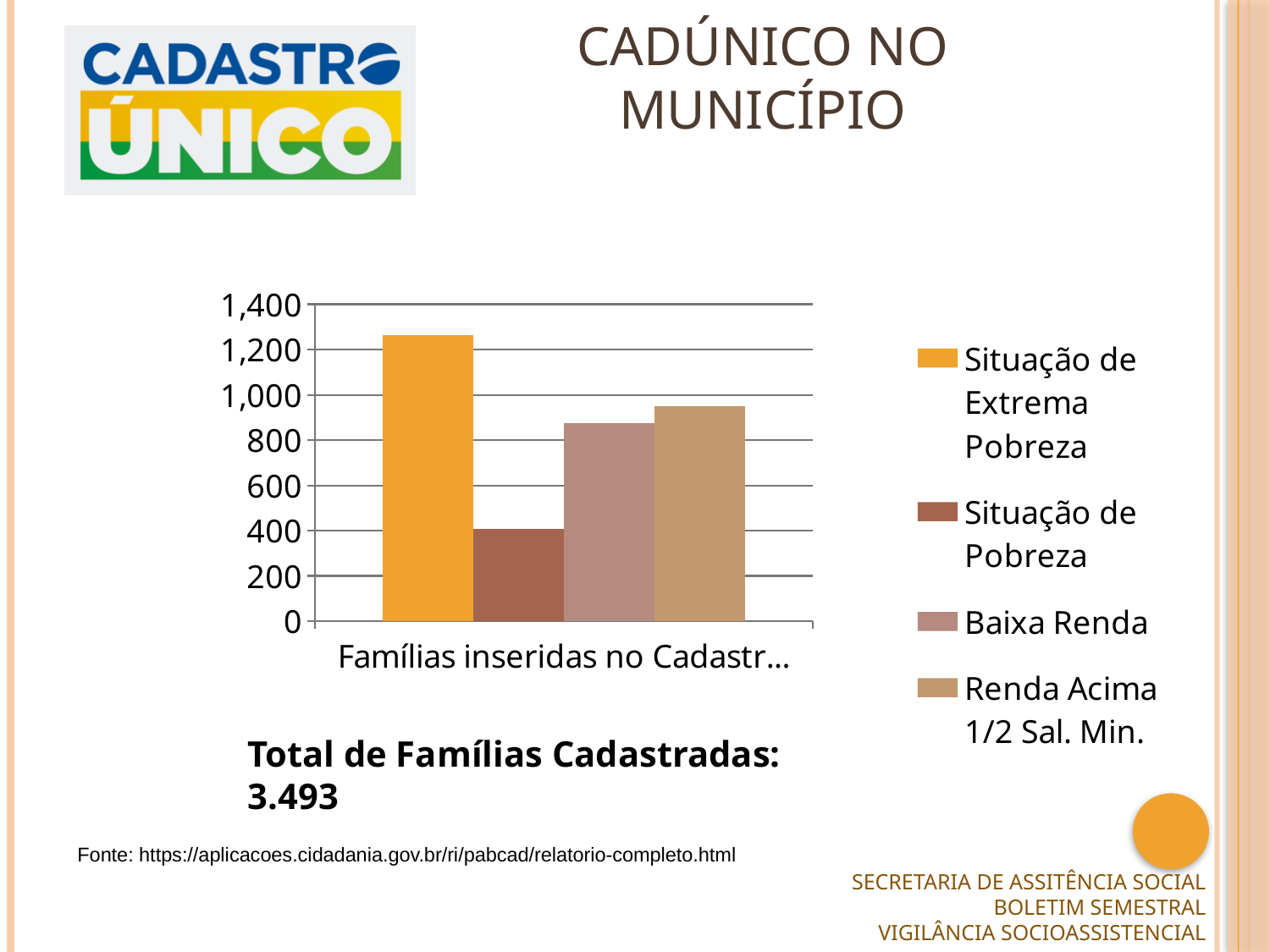
Is the value for Baixa Renda greater or less than 1,000? less Is the value for Renda Acima 1/2 Sal. Min. greater or less than 800? greater Which series has the lowest bar? Situação de Pobreza How many series does the legend list? 4 Which is larger, the bar for Situação de Extrema Pobreza or the bar for Baixa Renda? Situação de Extrema Pobreza What kind of chart is shown on the slide? bar chart Is the value for Situação de Extrema Pobreza greater or less than 1,000? greater Which is larger, the bar for Situação de Pobreza or the bar for Renda Acima 1/2 Sal. Min.? Renda Acima 1/2 Sal. Min. Which series has the highest bar? Situação de Extrema Pobreza How many categories are shown on the x axis of the chart? 1 What colour is the bar for Situação de Extrema Pobreza? orange